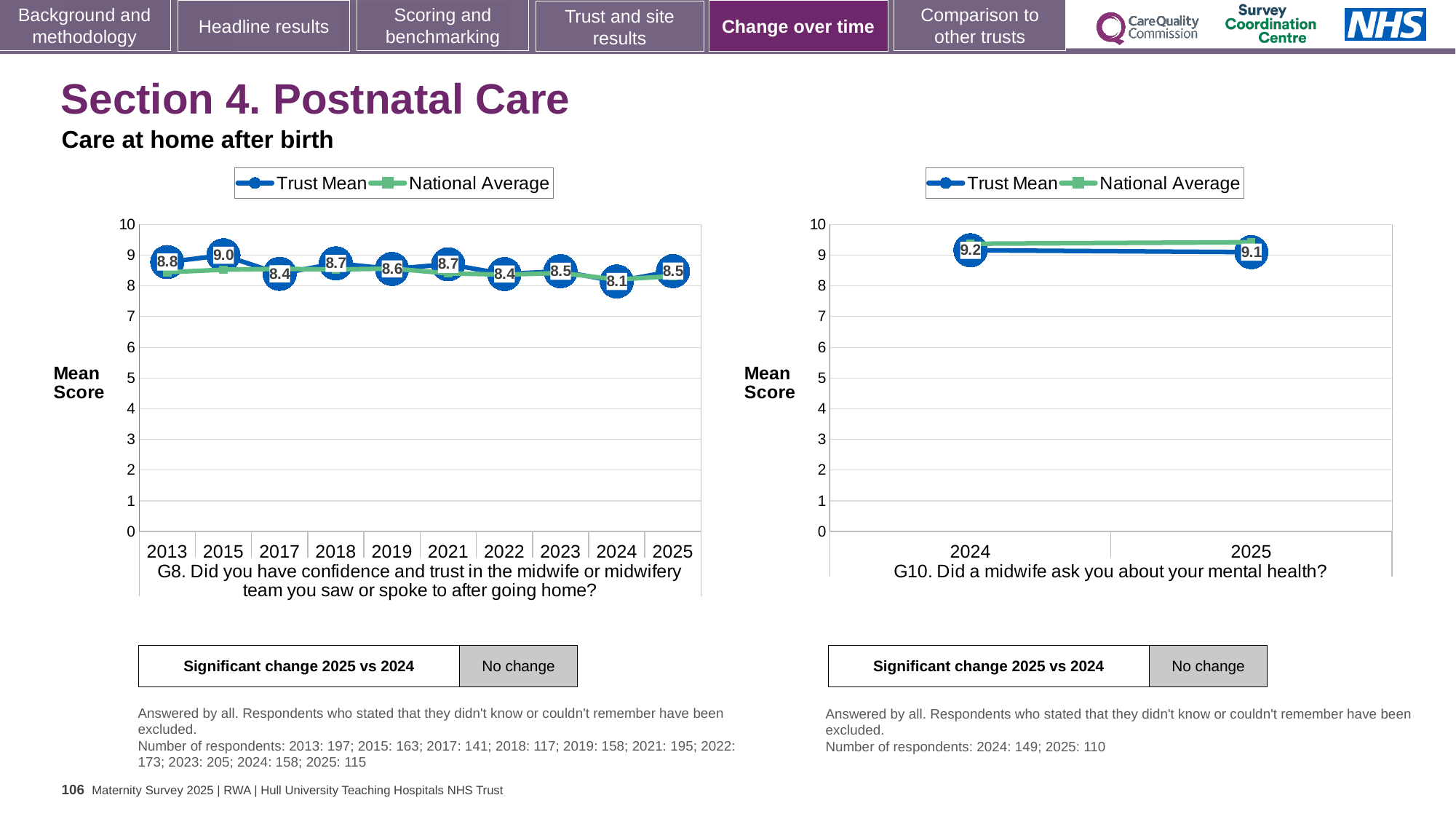
How many series does the legend of the G10 chart on the right list? 2 In the G10 chart on the right, is the National Average for 2025 greater or less than 8? greater In the G8 chart on the left, what is the difference between the Trust Mean in 2013 and in 2024? 0.7 How many years are plotted on the x axis of the G8 chart on the left? 10 In the G8 chart on the left, which year has the highest Trust Mean? 2015 In the G10 chart on the right, what is the Trust Mean for 2024? 9.2 In the G8 chart on the left, is the Trust Mean higher in 2018 or in 2022? 2018 In the G10 chart on the right, what is the difference between the Trust Mean in 2024 and in 2025? 0.1 In the G8 chart on the left, which year has the lowest Trust Mean? 2024 What type of chart is the G8 chart on the left? Line chart In the G8 chart on the left, what is the Trust Mean for 2015? 9.0 In the G8 chart on the left, what is the Trust Mean for 2024? 8.1